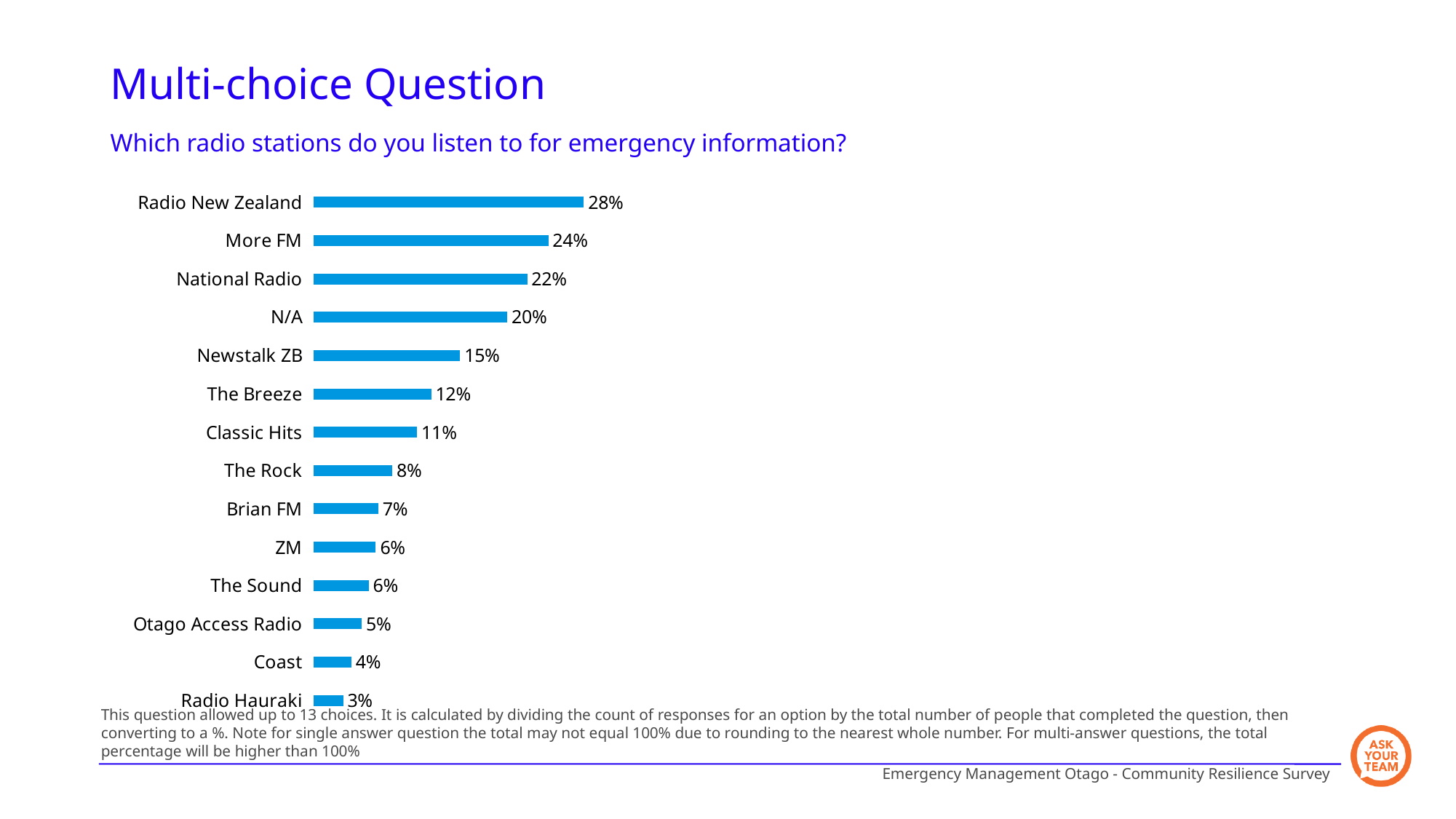
What is the value shown for Newstalk ZB? 15% What percentage of respondents listen to Radio New Zealand for emergency information? 28% What percentage is shown for Otago Access Radio? 5% What is the difference between Radio New Zealand and The Breeze? 16% Which has a higher percentage, N/A or Newstalk ZB? N/A What is the difference between the percentages for More FM and National Radio? 2% What type of chart is shown on the slide? Bar chart Which has a higher percentage, The Rock or Brian FM? The Rock What question does the chart answer, according to the subtitle? Which radio stations do you listen to for emergency information? Which category has the lowest percentage? Radio Hauraki How many categories are shown in the chart? 14 Which radio station has the highest percentage? Radio New Zealand